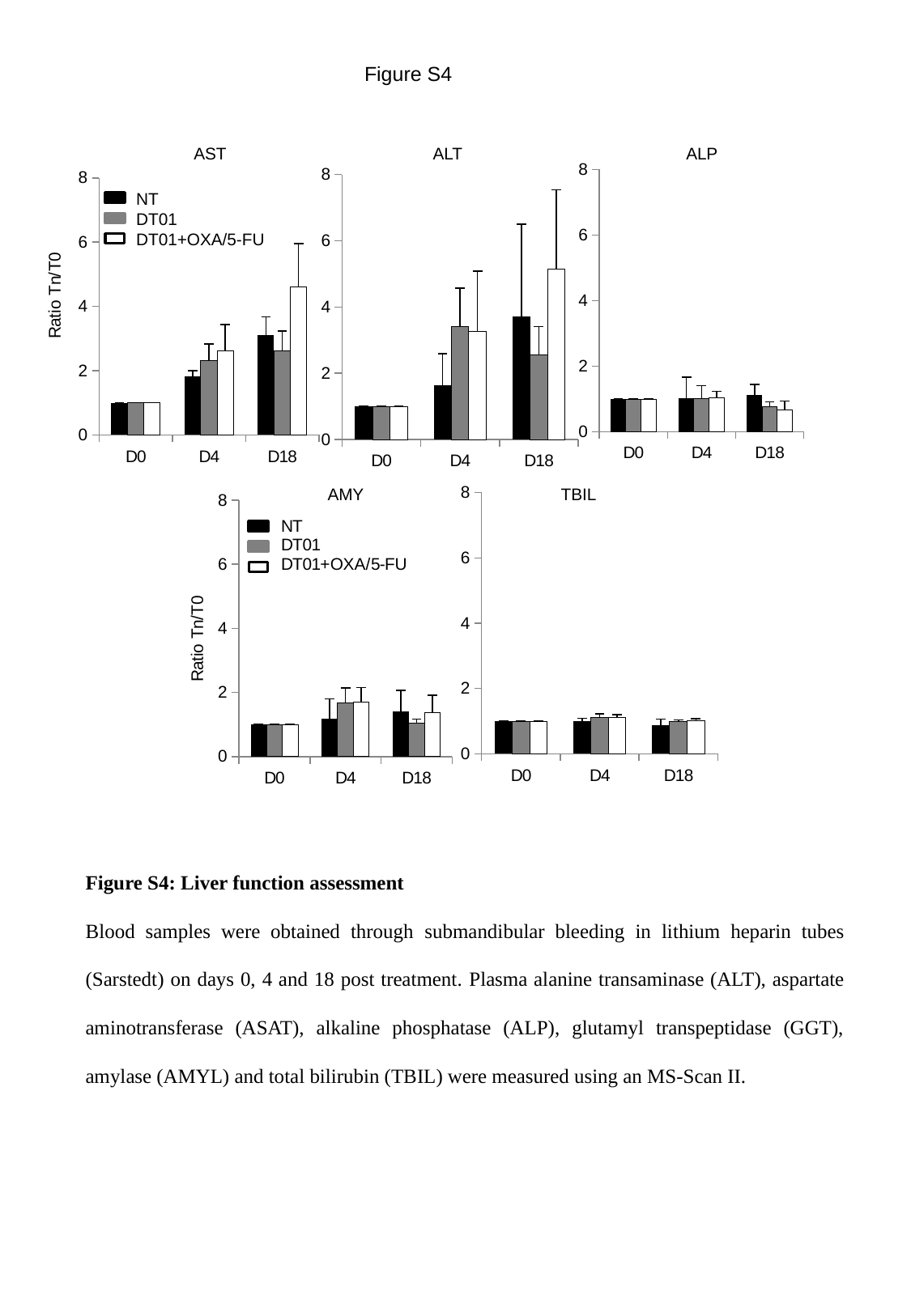
In the AST chart, how many categories are shown on the x axis? 3 In the AMY chart, is the value for DT01 at D4 greater or less than 2? less In the AST chart, what kind of chart is shown? bar chart In the AST chart, which is larger for NT: the value at D4 or the value at D18? D18 In the ALT chart, at which category is the DT01+OXA/5-FU bar highest? D18 In the ALT chart, which is larger at D4: the NT bar or the DT01 bar? DT01 In the ALT chart, is the value for NT at D18 greater or less than 2? greater In the ALP chart, is the value for DT01+OXA/5-FU at D18 greater or less than 2? less What is the y-axis label of the AST chart? Ratio Tn/T0 In the AST chart, how many series does the legend list? 3 In the AST chart, do the NT values rise or fall from D0 to D18? rise